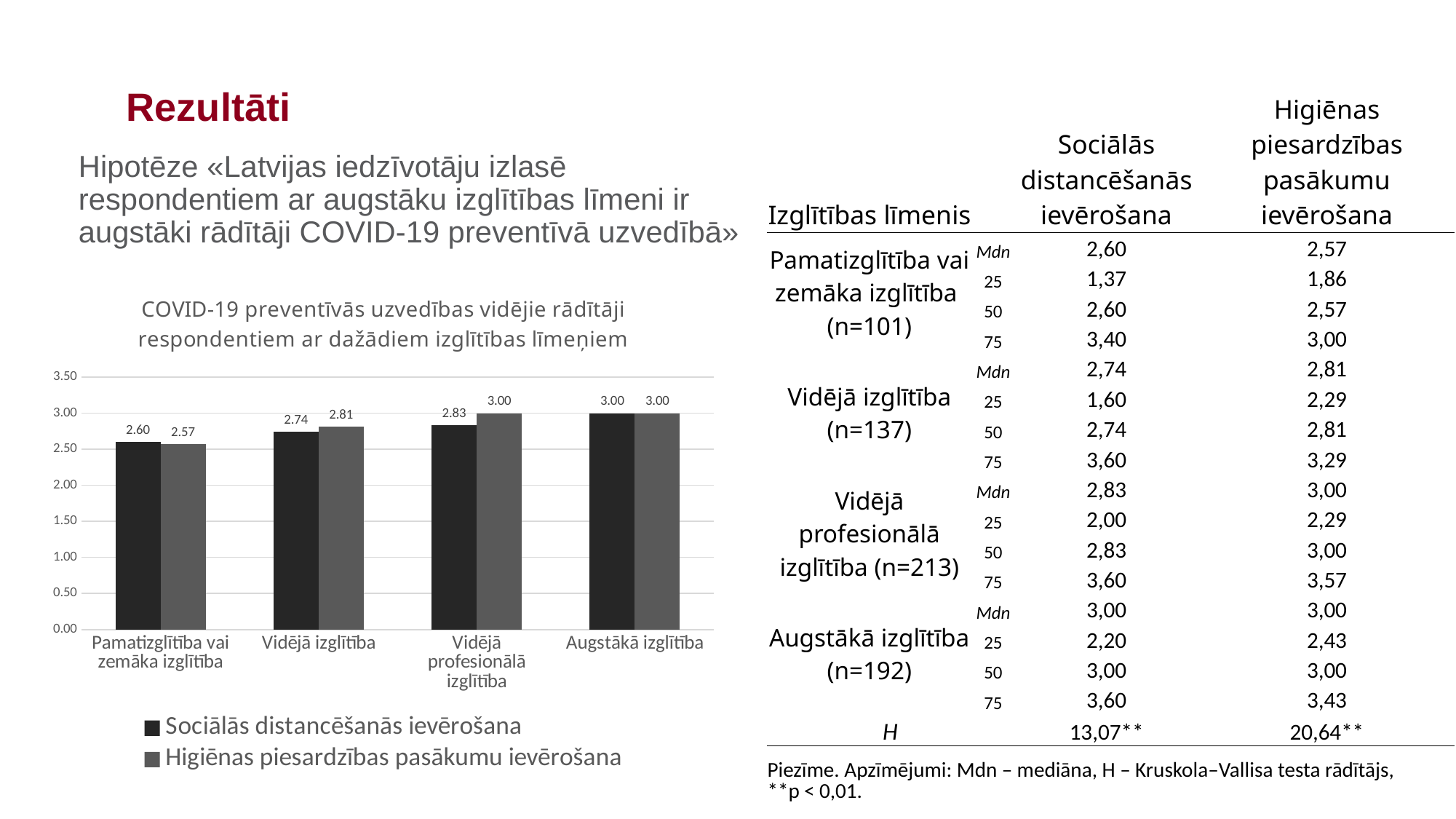
How many series does the chart legend list? 2 For Vidējā izglītība, which series has the larger value? Higiēnas piesardzības pasākumu ievērošana Which education level has the lowest value for Higiēnas piesardzības pasākumu ievērošana? Pamatizglītība vai zemāka izglītība What is the value of Higiēnas piesardzības pasākumu ievērošana for Vidējā profesionālā izglītība? 3.00 What is the difference in Sociālās distancēšanās ievērošana between Augstākā izglītība and Pamatizglītība vai zemāka izglītība? 0.40 What type of chart is shown on the slide? Bar chart What is the value of Sociālās distancēšanās ievērošana for Vidējā izglītība? 2.74 What is the value of Higiēnas piesardzības pasākumu ievērošana for Pamatizglītība vai zemāka izglītība? 2.57 Do the values for Sociālās distancēšanās ievērošana rise or fall from Pamatizglītība vai zemāka izglītība to Augstākā izglītība? Rise How many education level categories are shown on the x axis of the chart? 4 For Vidējā profesionālā izglītība, what is the difference between Higiēnas piesardzības pasākumu ievērošana and Sociālās distancēšanās ievērošana? 0.17 Which education level has the highest value for Sociālās distancēšanās ievērošana? Augstākā izglītība